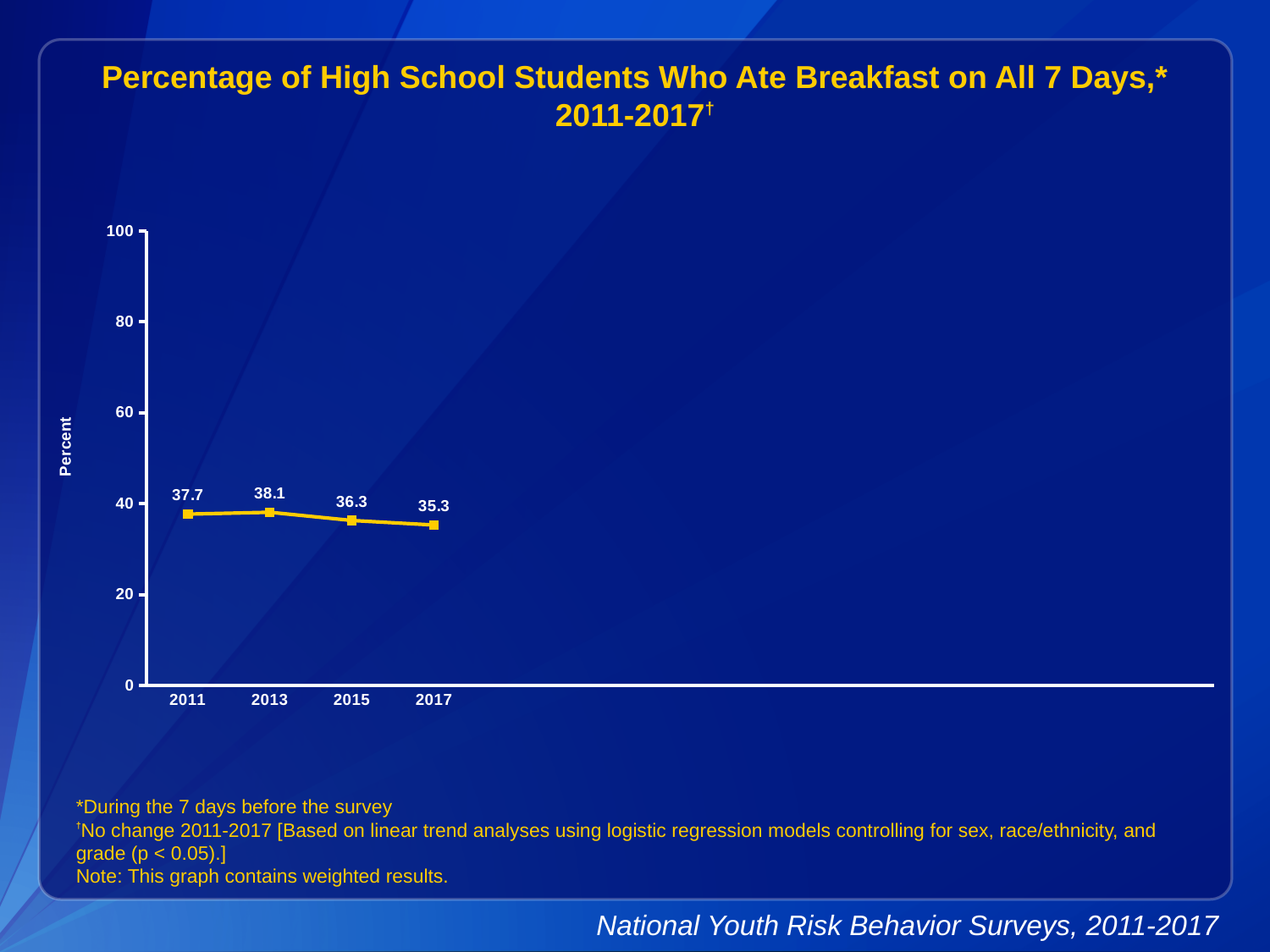
What is the value for 2017? 35.3 What kind of chart is shown? line chart Which year has the lowest value? 2017 What is the value for 2015? 36.3 What is the label on the y axis? Percent Which is larger, the value for 2011 or the value for 2015? 2011 How many years are plotted on the chart? 4 Do the values rise or fall from 2013 to 2017? fall Which year has the highest value? 2013 What is the difference between the values for 2013 and 2017? 2.8 Is the value for 2017 greater or less than 40? less What is the value for 2011? 37.7